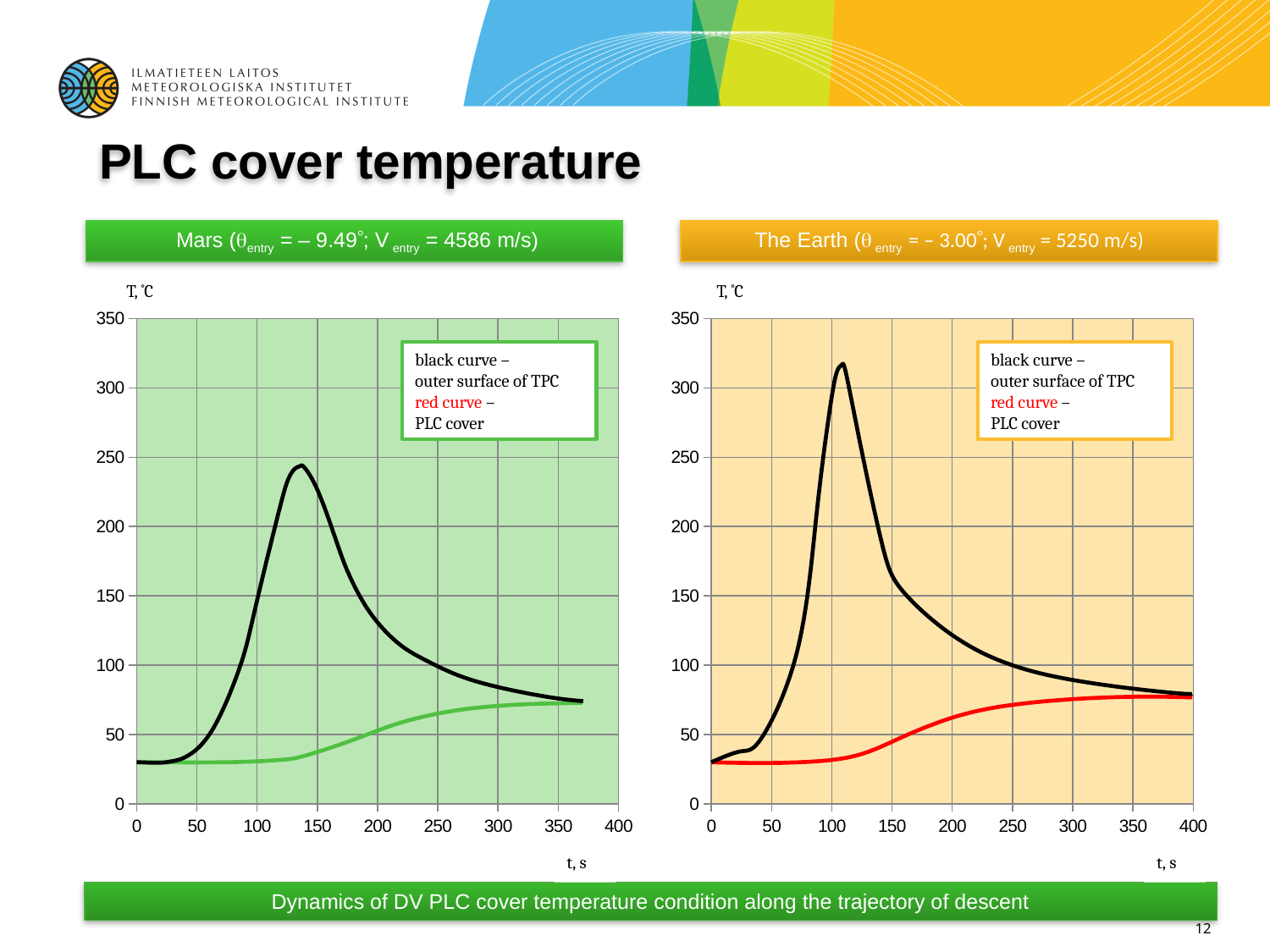
On the Mars chart, is the peak value of the black curve greater or less than 200? greater How many curves are plotted on The Earth chart on the right? 2 On the Mars chart, is the value of the black curve at t = 0 greater or less than 50? less On the Mars chart, does the black curve rise or fall between t = 150 and t = 350? fall What is the label of the x axis on the Mars chart? t, s On The Earth chart, is the black curve at t = 200 greater or less than 100? greater On The Earth chart, which curve represents the outer surface of TPC according to the legend box? black curve What kind of chart is the Mars chart on the left? line chart Which chart shows the higher peak of the black curve, Mars or The Earth? The Earth On The Earth chart, does the red (PLC cover) curve rise or fall overall along the x axis? rise